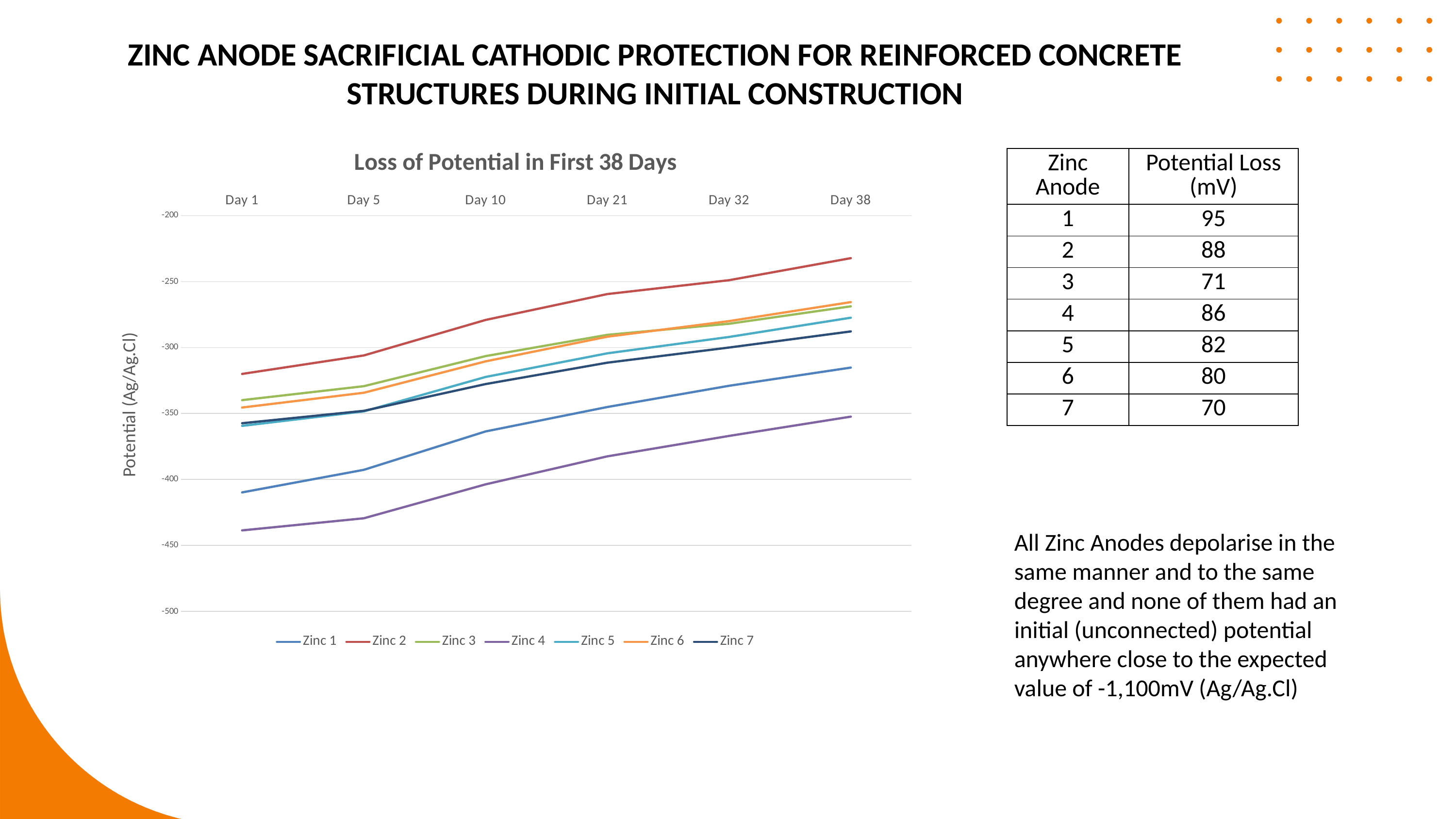
What kind of chart is shown on the slide? Line chart Is the value for Zinc 4 at Day 1 greater or less than -400? less Is the value for Zinc 2 at Day 38 greater or less than -250? greater Do the potential values for Zinc 1 rise or fall from Day 1 to Day 38? Rise At Day 21, which is higher: Zinc 2 or Zinc 4? Zinc 2 What is the title of the chart? Loss of Potential in First 38 Days How many day points are shown along the x axis of the chart? 6 How many series does the chart legend list? 7 Which series has the highest potential at Day 38? Zinc 2 Is the value for Zinc 2 at Day 1 greater or less than -350? greater What is the label on the y axis of the chart? Potential (Ag/Ag.Cl) Which series has the lowest potential at Day 1? Zinc 4